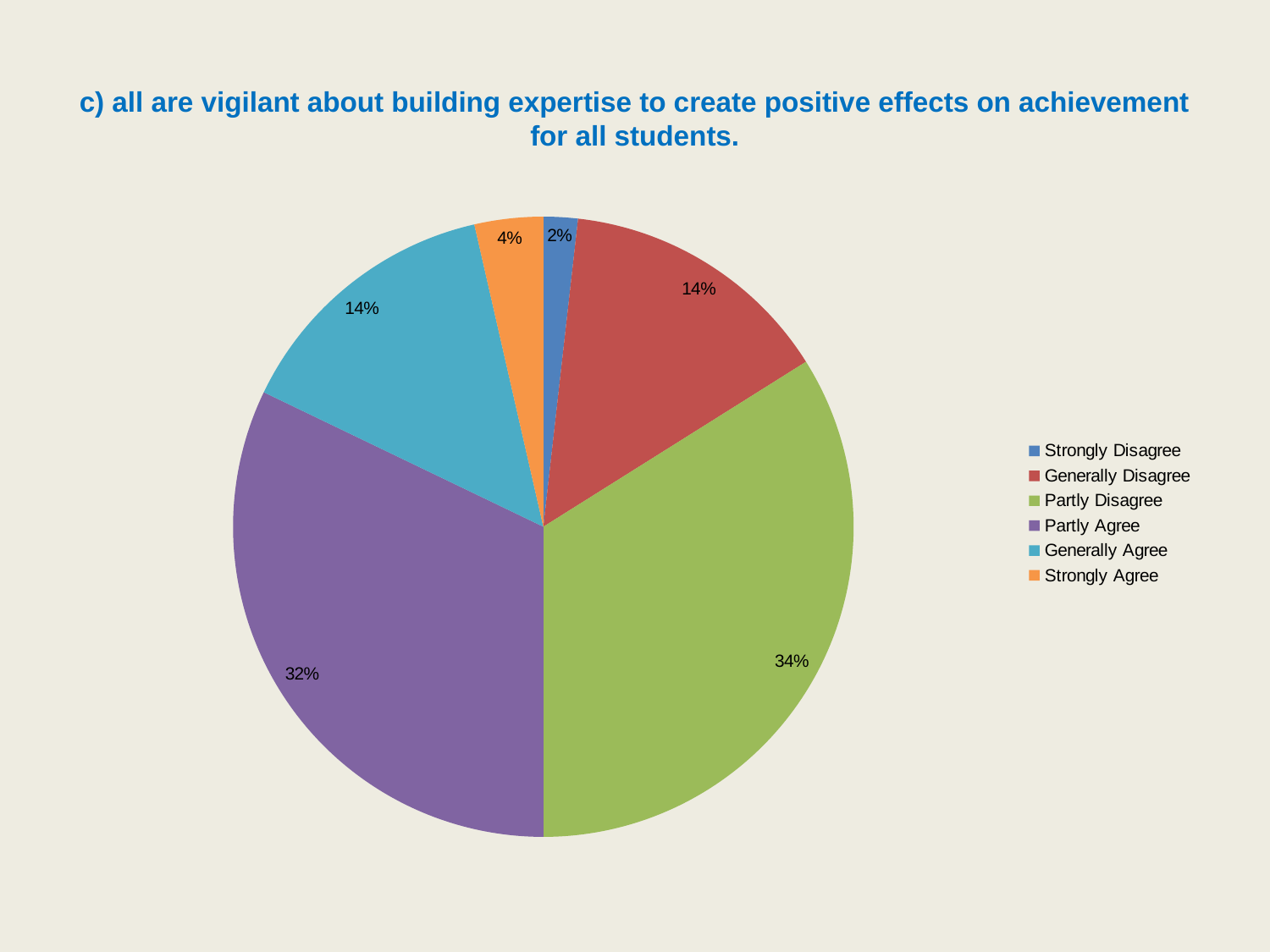
What is the difference between the Partly Disagree and Partly Agree shares? 2% What colour is the Partly Agree slice? purple What kind of chart is shown on the slide? pie chart What share of the pie is Partly Agree? 32% Which category has the smallest slice of the pie? Strongly Disagree What share of the pie is Strongly Disagree? 2% What share of the pie is Strongly Agree? 4% How many categories does the legend list? 6 Which is larger, the Strongly Agree slice or the Strongly Disagree slice? Strongly Agree Which category has the largest slice of the pie? Partly Disagree What share of the pie is Generally Disagree? 14% What share of the pie is Partly Disagree? 34%